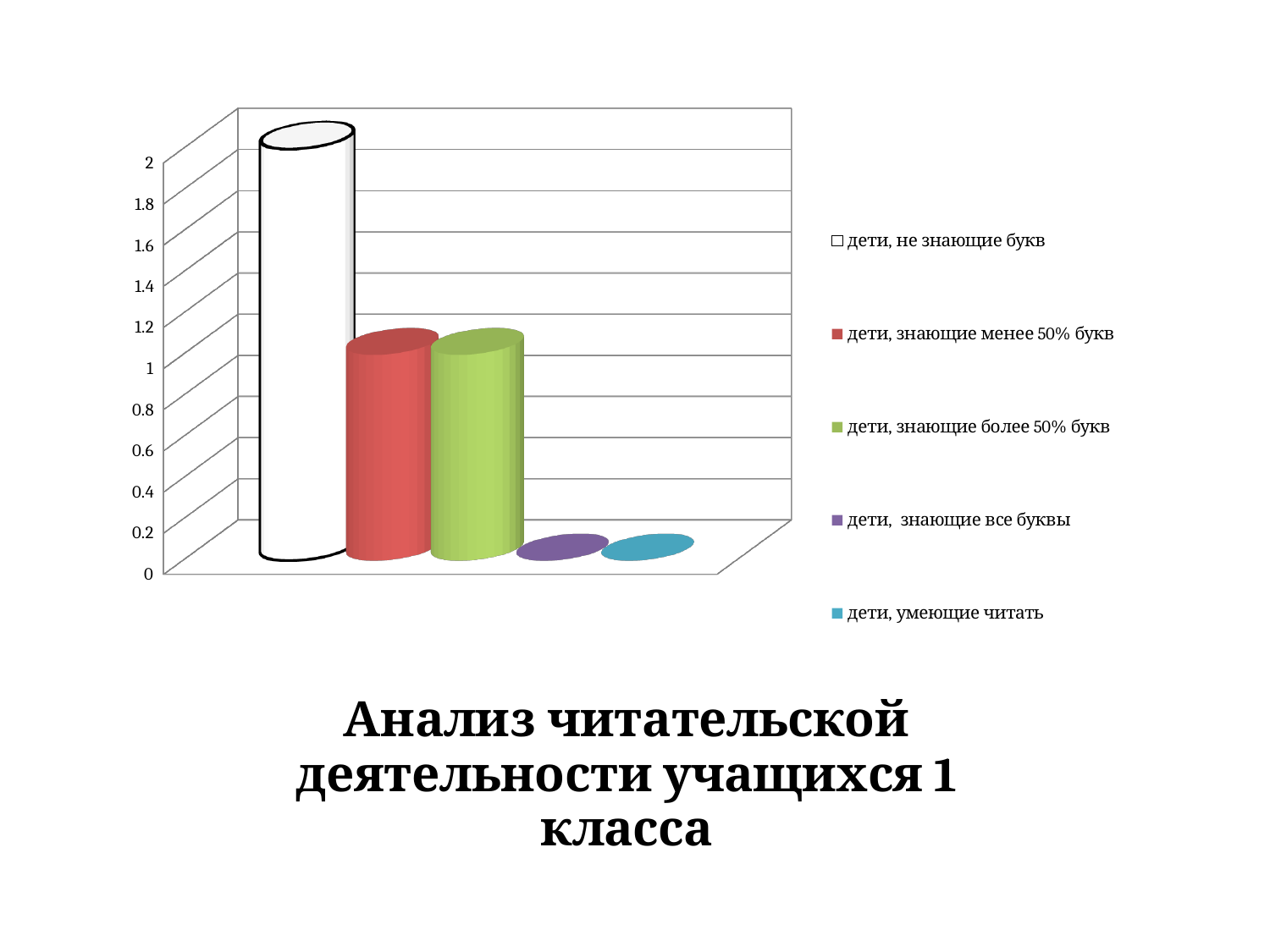
Is the value for "дети, знающие все буквы" greater or less than 0.4? less Is the value for "дети, знающие менее 50% букв" greater or less than 1.4? less Which is larger: the value for "дети, знающие более 50% букв" or the value for "дети, умеющие читать"? дети, знающие более 50% букв Is the value for "дети, умеющие читать" greater or less than 0.4? less What kind of chart is shown on the slide? bar chart How many series does the legend list? 5 What is the title shown below the chart? Анализ читательской деятельности учащихся 1 класса Which is larger: the value for "дети, не знающие букв" or the value for "дети, знающие менее 50% букв"? дети, не знающие букв What colour is the bar for "дети, знающие более 50% букв"? green Which series has the highest bar? дети, не знающие букв